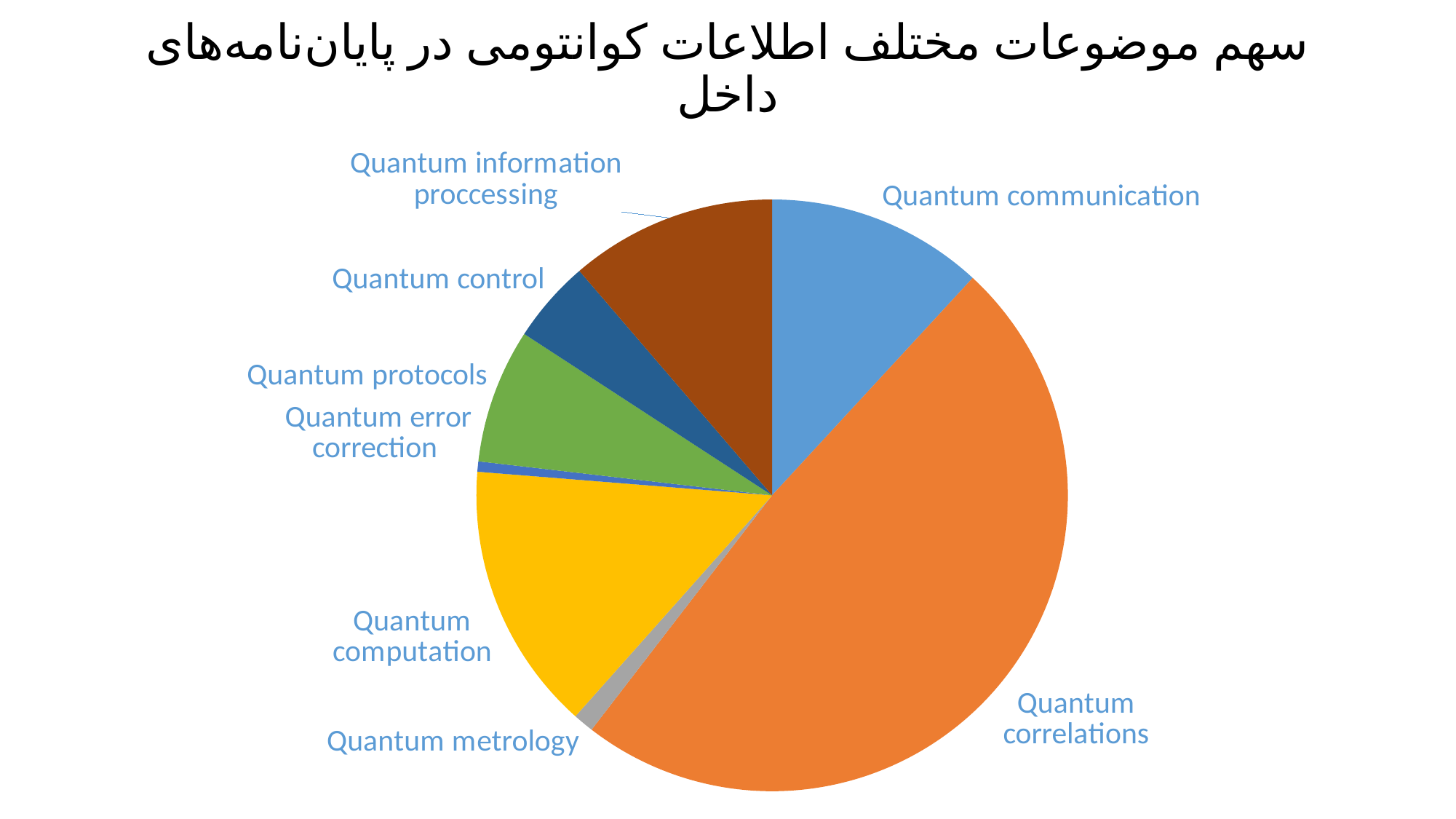
Which slice is larger, Quantum correlations or Quantum computation? Quantum correlations What kind of chart is shown on the slide? pie chart Which slice is larger, Quantum metrology or Quantum error correction? Quantum metrology Which category has the smallest slice of the pie? Quantum error correction What colour is the Quantum correlations slice? orange What colour is the Quantum computation slice? yellow Which category has the largest slice of the pie? Quantum correlations Which slice is larger, Quantum computation or Quantum metrology? Quantum computation How many slices does the pie chart have? 8